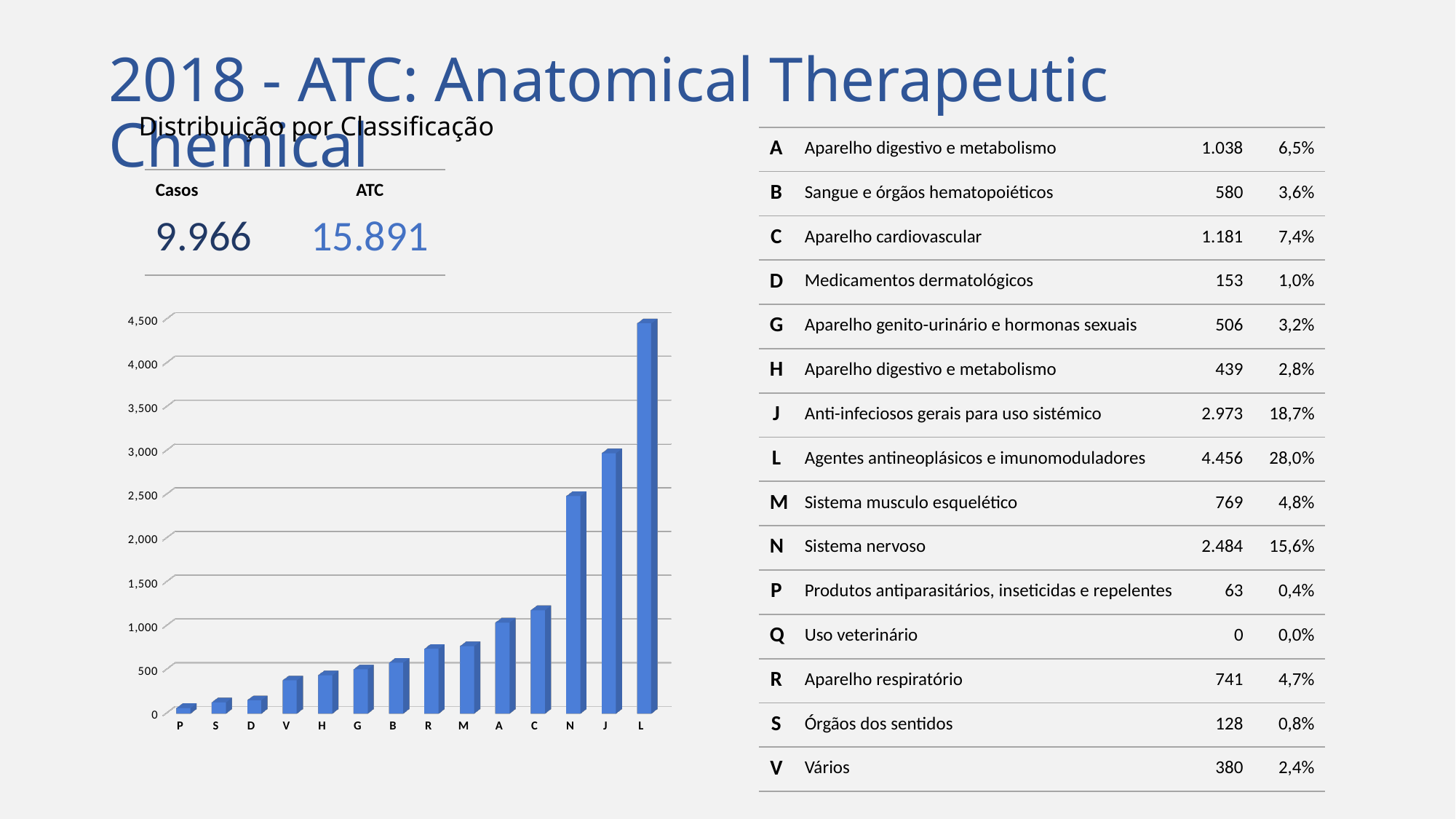
Which category has the highest bar in the chart? L Which bar is taller, N or C? N Do the bar values rise or fall from left to right along the x axis? rise Which category has the lowest bar in the chart? P What is the subtitle printed above the chart? Distribuição por Classificação Is the value for M greater or less than 1,000? less Is the value for V greater or less than 500? less How many categories are shown on the x axis of the bar chart? 14 What type of chart is shown on the slide? bar chart Is the value for L greater or less than 4,000? greater Which bar is taller, J or N? J